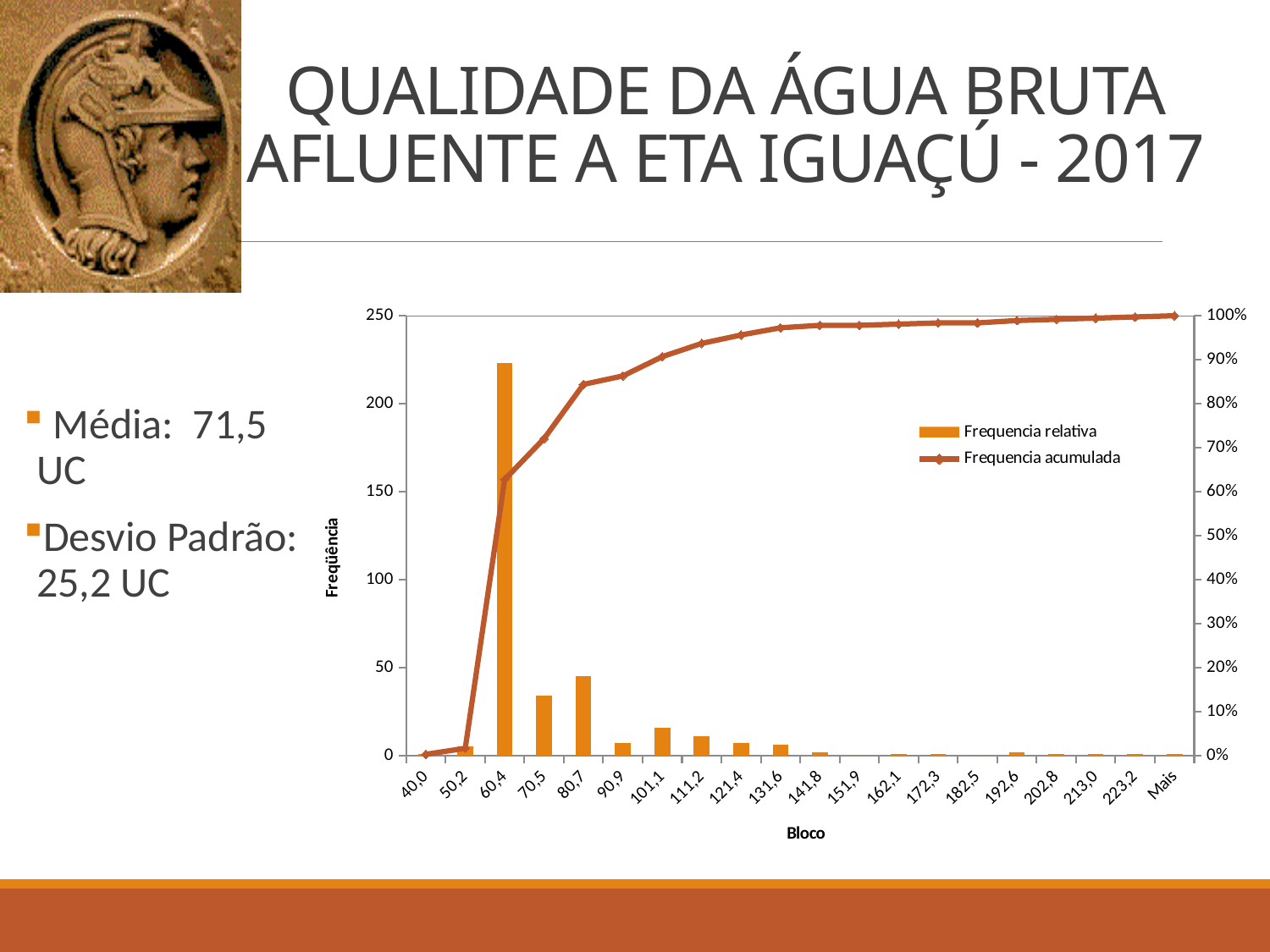
What kind of chart is shown on the slide? Combined bar and line chart How many series does the legend list? 2 Does the Frequencia acumulada line rise or fall along the x axis? Rise Is the Frequencia relativa value for 60,4 greater or less than 200? greater How many Bloco categories are shown on the x axis? 20 Is the Frequencia relativa value for 80,7 greater or less than 50? less Which has the larger Frequencia relativa bar, 70,5 or 80,7? 80,7 What is the title of the chart's x axis? Bloco Is the Frequencia relativa value for 70,5 greater or less than 50? less Which Bloco category has the highest Frequencia relativa bar? 60,4